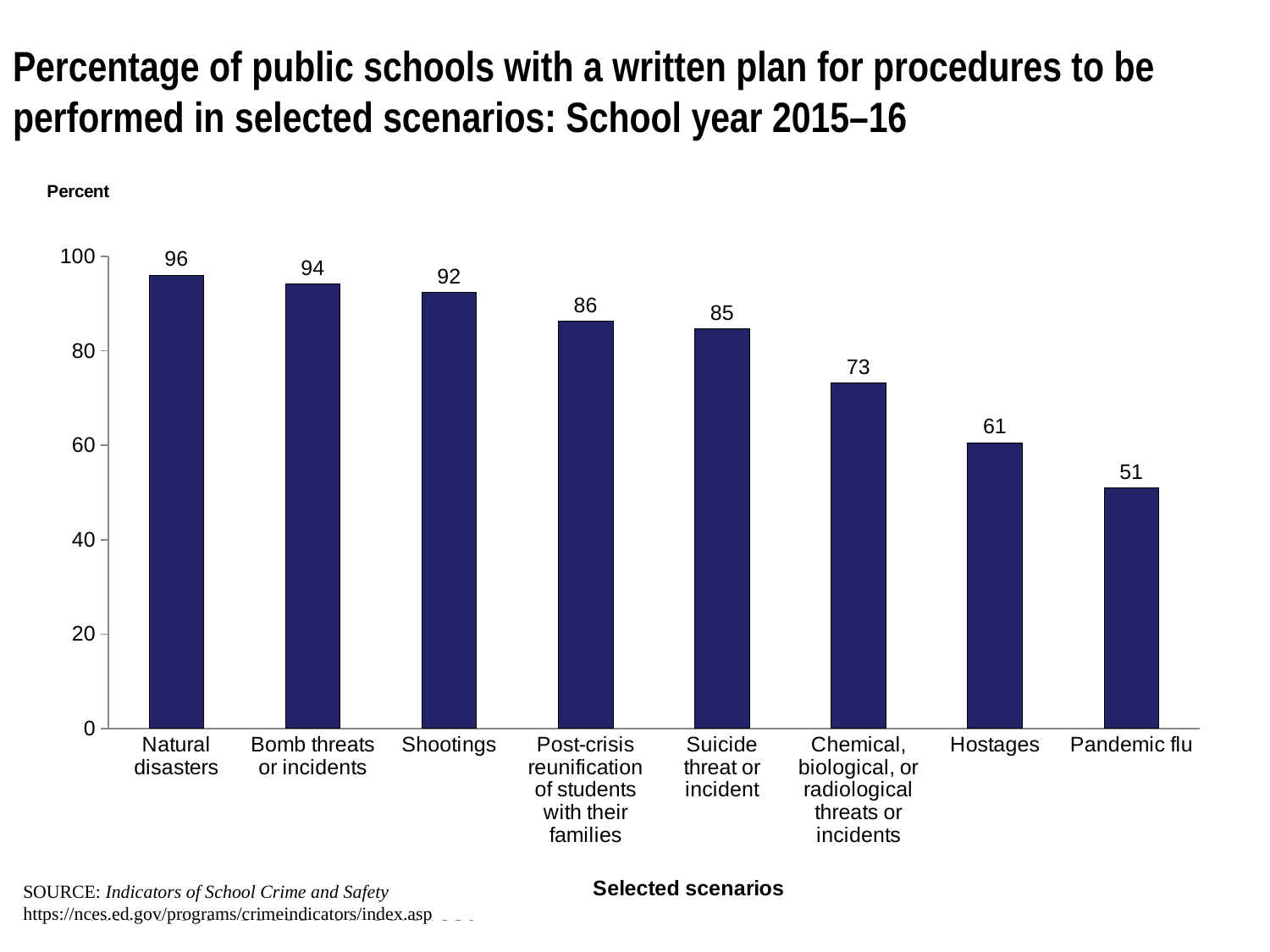
How many scenarios are shown on the chart? 8 What percentage of public schools had a written plan for natural disasters? 96 What kind of chart is shown on the slide? Bar chart Which scenario has the lowest percentage of schools with a written plan? Pandemic flu What is the label of the vertical axis? Percent Which is larger: the value for Suicide threat or incident, or the value for Chemical, biological, or radiological threats or incidents? Suicide threat or incident What is the value for Pandemic flu? 51 Is the value for Chemical, biological, or radiological threats or incidents greater or less than 80? less Do the values rise or fall from left to right across the scenarios? Fall Which scenario has the highest percentage of schools with a written plan? Natural disasters What is the value for Hostages? 61 What is the difference between the values for Shootings and Hostages? 31